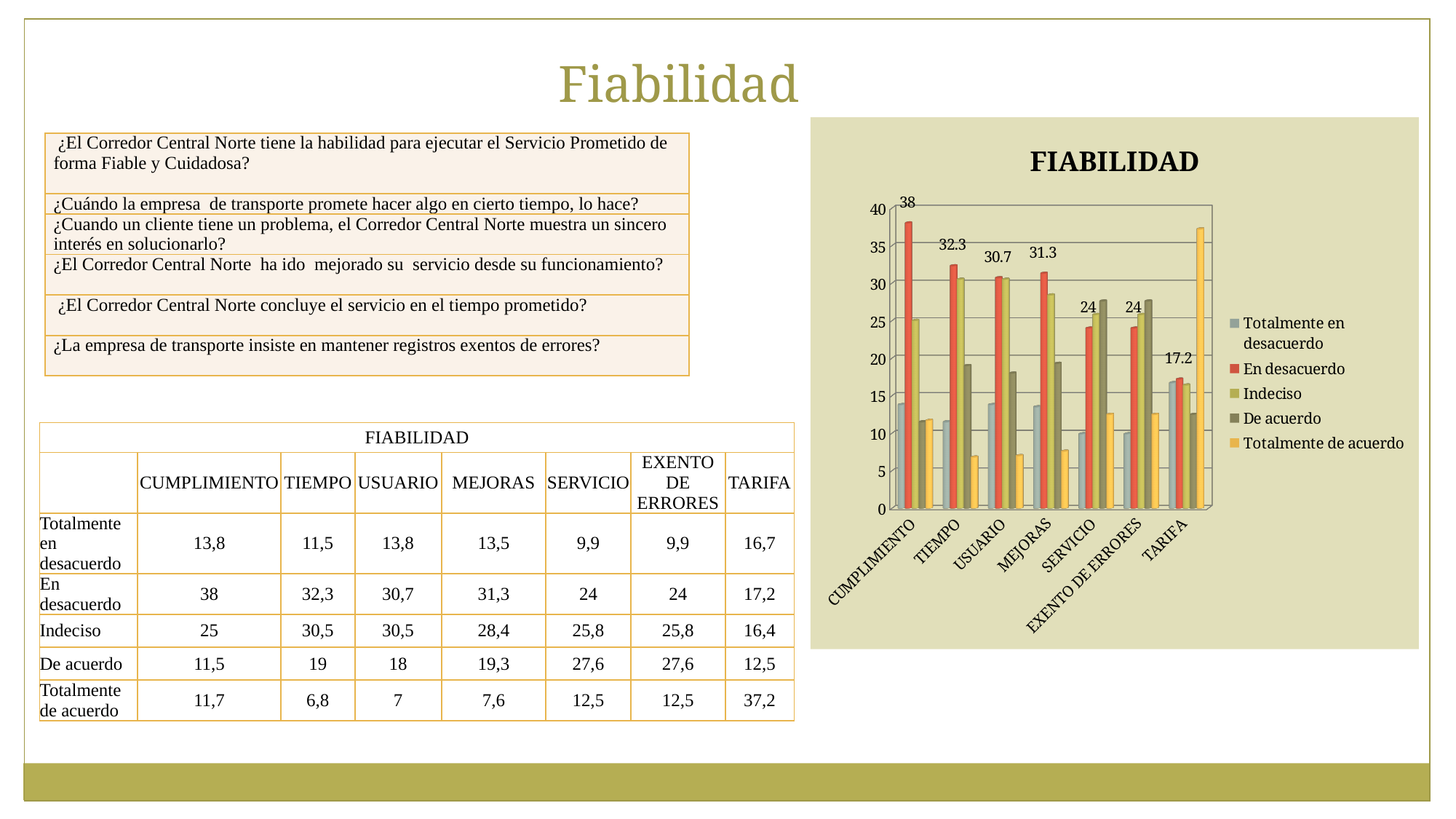
What is the difference between the En desacuerdo values for CUMPLIMIENTO and TARIFA? 20.8 How many categories are shown on the x axis of the chart? 7 Which category has the highest value for the En desacuerdo series? CUMPLIMIENTO Is the Totalmente de acuerdo value for TIEMPO greater or less than 10? less Which category has the lowest value for the En desacuerdo series? TARIFA What is the value of the En desacuerdo series for TARIFA? 17.2 Is the Totalmente de acuerdo value for TARIFA greater or less than 35? greater What type of chart is shown on the slide? bar chart What is the value of the En desacuerdo series for TIEMPO? 32.3 Which has the larger En desacuerdo value, USUARIO or MEJORAS? MEJORAS How many series does the chart legend list? 5 What is the value of the En desacuerdo series for CUMPLIMIENTO? 38